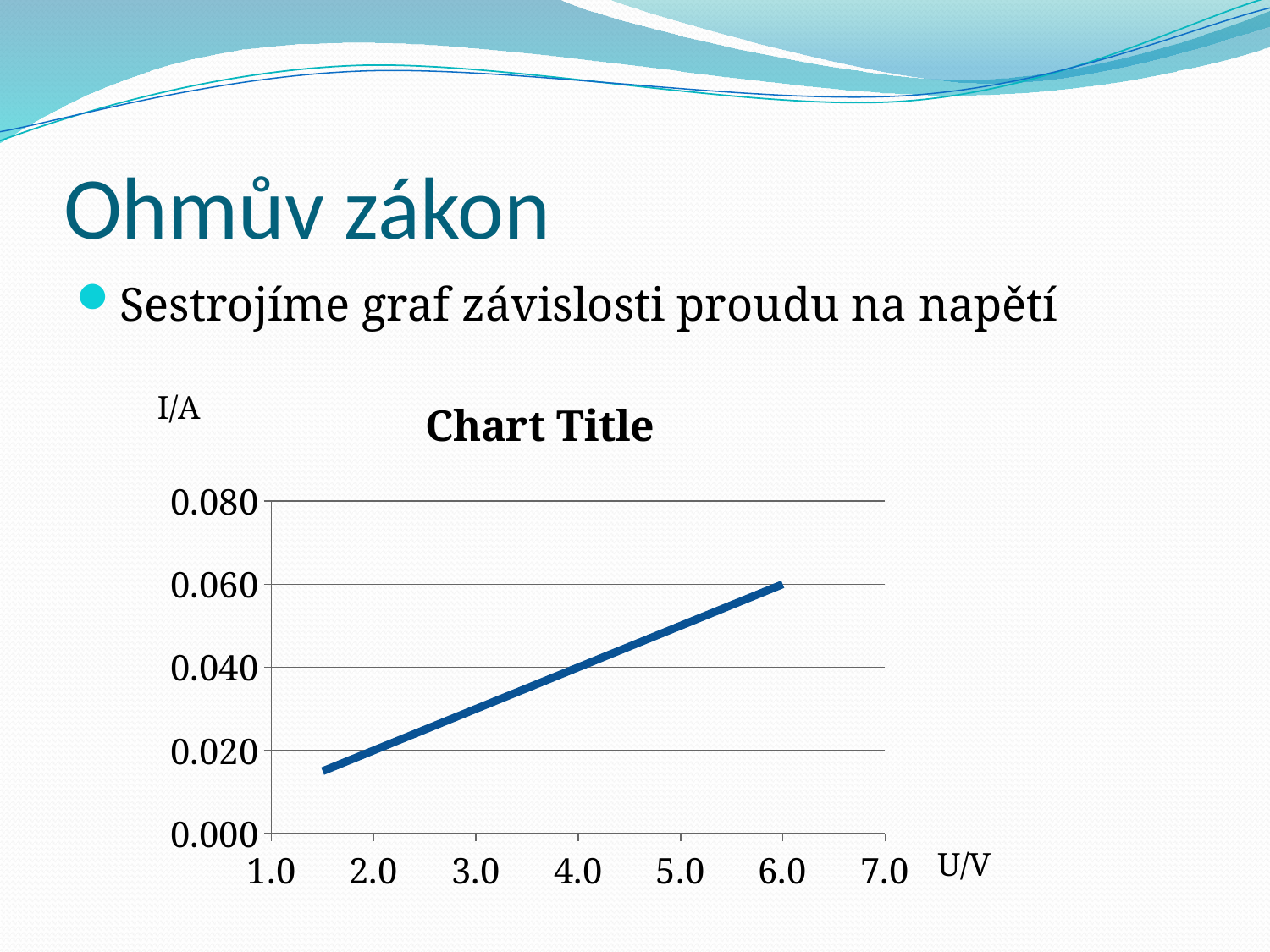
What label is shown on the vertical axis of the chart? I/A How many tick labels are shown on the horizontal (U/V) axis? 7 What kind of chart is shown on the slide? line chart Does the current I/A rise or fall as the voltage U/V increases along the x axis? rises What is the title printed above the chart? Chart Title Which has the larger I/A value: U/V = 3.0 or U/V = 5.0? 5.0 What is the highest tick value shown on the vertical (I/A) axis? 0.080 Is the value of I/A at U/V = 4.0 greater or less than 0.060? less Is the value of I/A at U/V = 2.0 greater or less than 0.040? less What is the highest tick value shown on the horizontal (U/V) axis? 7.0 Is the value of I/A at U/V = 4.0 greater or less than 0.020? greater